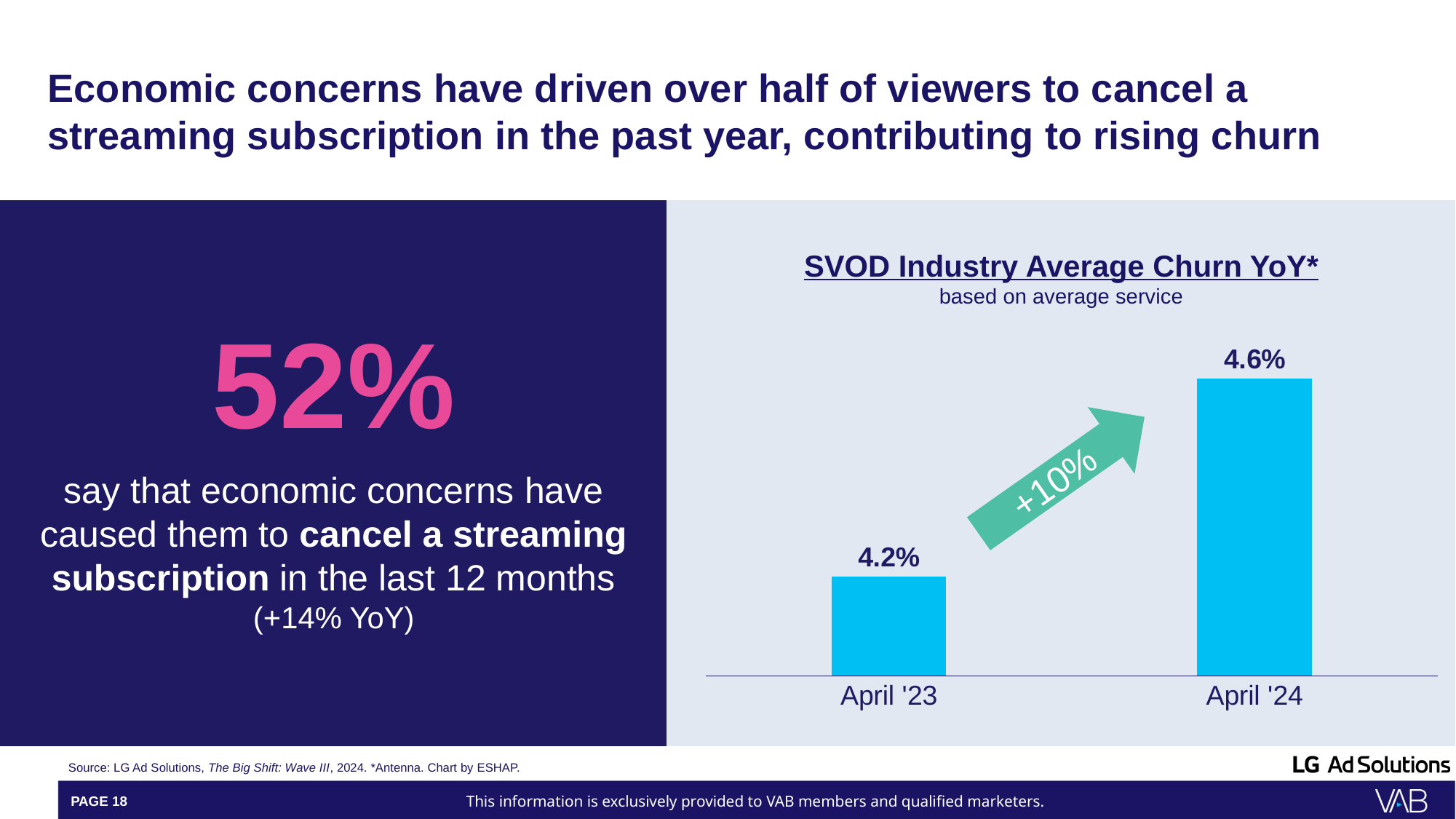
What is the SVOD industry average churn for April '24? 4.6% How many categories are shown on the x axis of the chart? 2 What percentage change is shown on the arrow between the two bars? +10% Which category has the highest churn value in the chart? April '24 What is the title of the chart? SVOD Industry Average Churn YoY* Do the churn values rise or fall from April '23 to April '24? Rise What is the difference in churn between April '24 and April '23? 0.4% What kind of chart is shown on the slide? Bar chart Which period has the higher churn value, April '23 or April '24? April '24 Which category has the lowest churn value in the chart? April '23 What is the SVOD industry average churn for April '23? 4.2%